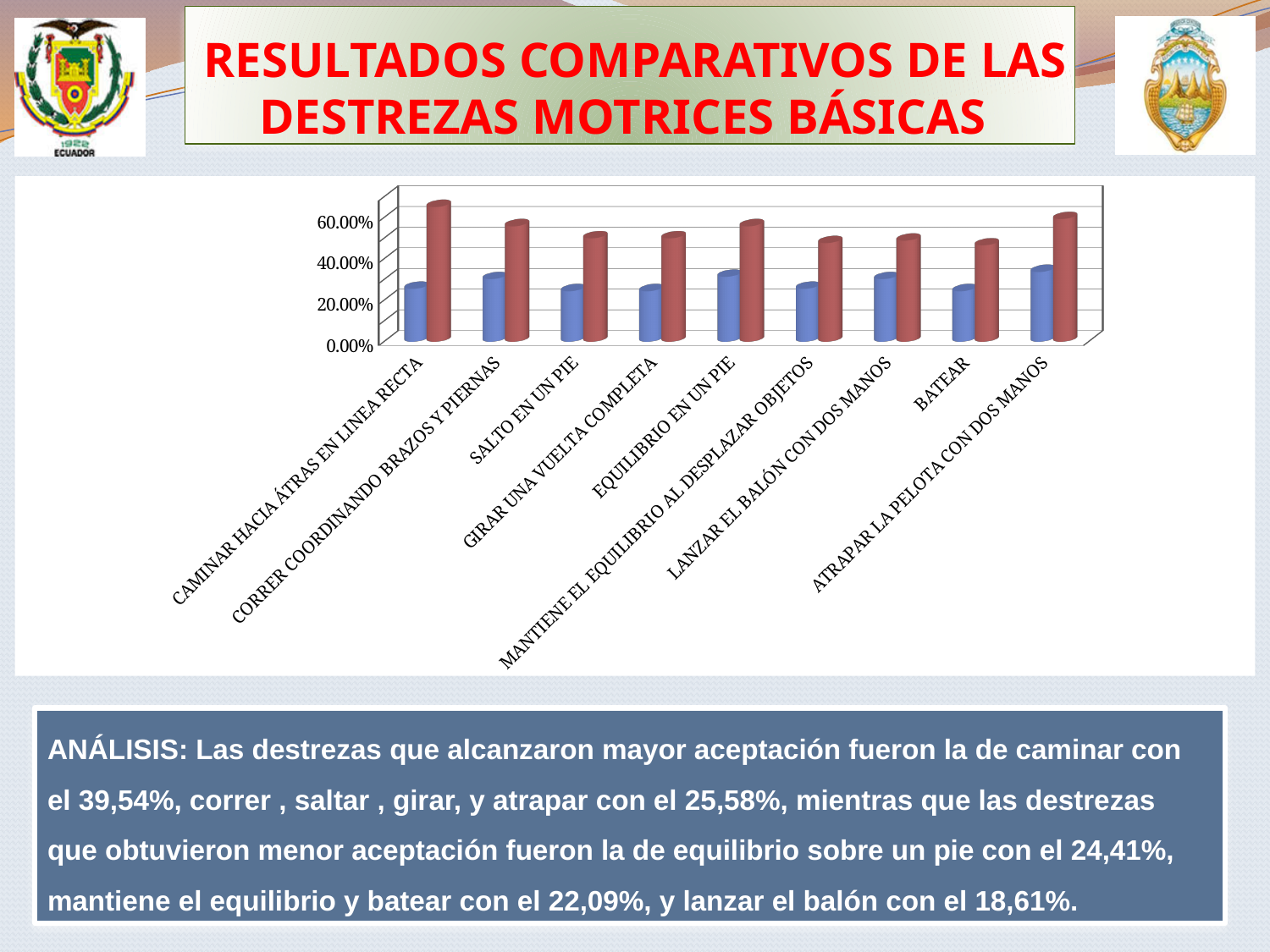
How many bars are drawn for each category in the chart? 2 Is the blue bar for BATEAR greater or less than 20.00%? greater Is the red bar for BATEAR greater or less than 60.00%? less What kind of chart is shown on the slide? Bar chart Is the red bar for CAMINAR HACIA ÁTRAS EN LINEA RECTA greater or less than 60.00%? greater Which category has the tallest red bar? CAMINAR HACIA ÁTRAS EN LINEA RECTA How many categories are shown along the x axis of the chart? 9 For GIRAR UNA VUELTA COMPLETA, which bar is taller, the blue one or the red one? The red one Which red bar is taller, CAMINAR HACIA ÁTRAS EN LINEA RECTA or BATEAR? CAMINAR HACIA ÁTRAS EN LINEA RECTA